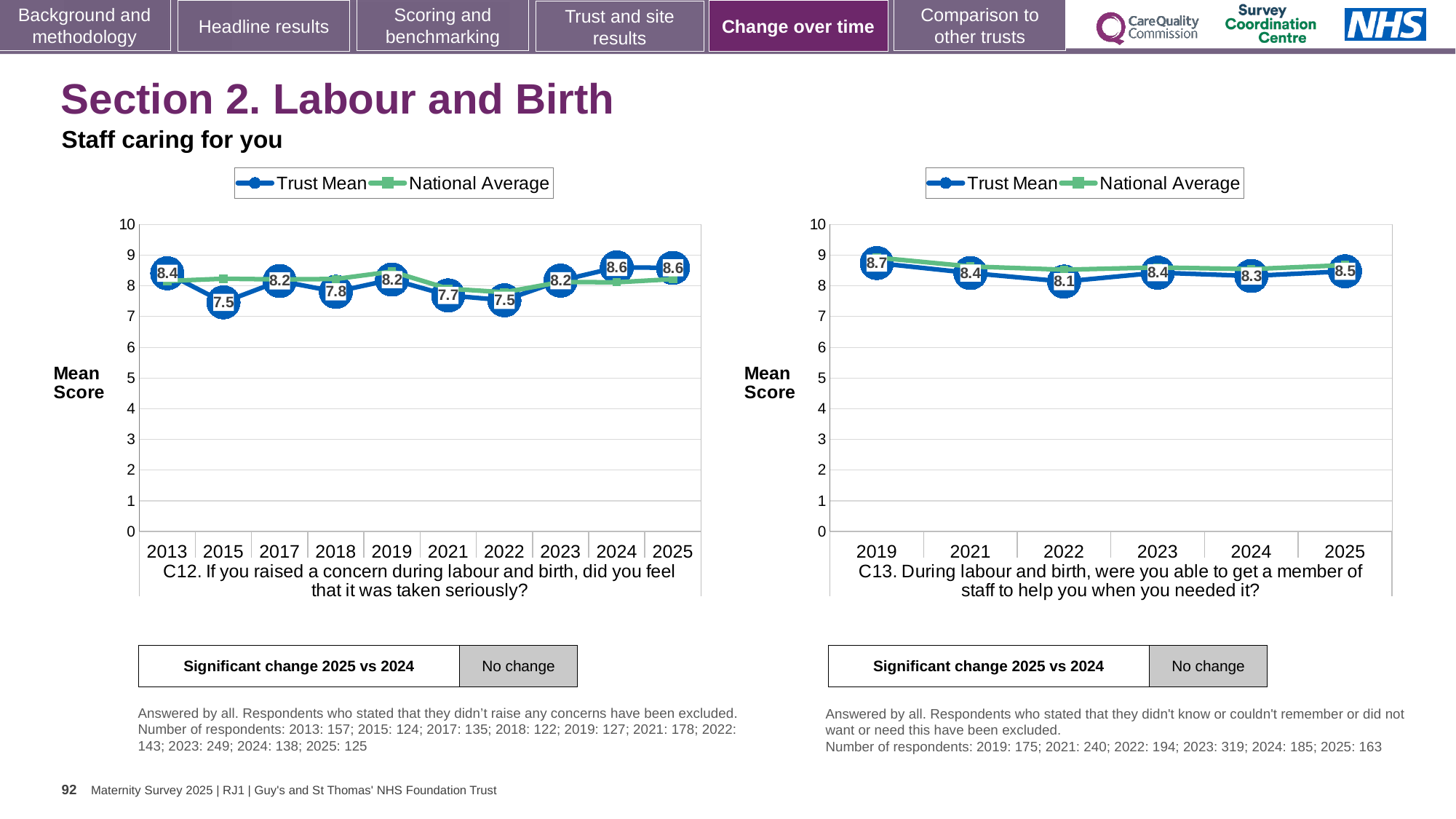
In the C12 chart, what is the difference between the Trust Mean scores for 2025 and 2022? 1.1 In the C13 chart, which year has the highest Trust Mean score? 2019 In the C13 chart, which year has the lowest Trust Mean score? 2022 In the C13 chart, what is the Trust Mean score for 2022? 8.1 What type of chart is the C13 chart? Line chart In the C12 chart, is the Trust Mean score for 2018 larger than the Trust Mean score for 2023? No In the C13 chart, what is the difference between the Trust Mean scores for 2019 and 2022? 0.6 In the C13 chart, what is the Trust Mean score for 2025? 8.5 How many years are plotted on the x axis of the C12 chart? 10 How many series does the legend of the C13 chart list? 2 In the C12 chart, what is the Trust Mean score for 2015? 7.5 In the C12 chart, what is the Trust Mean score for 2024? 8.6